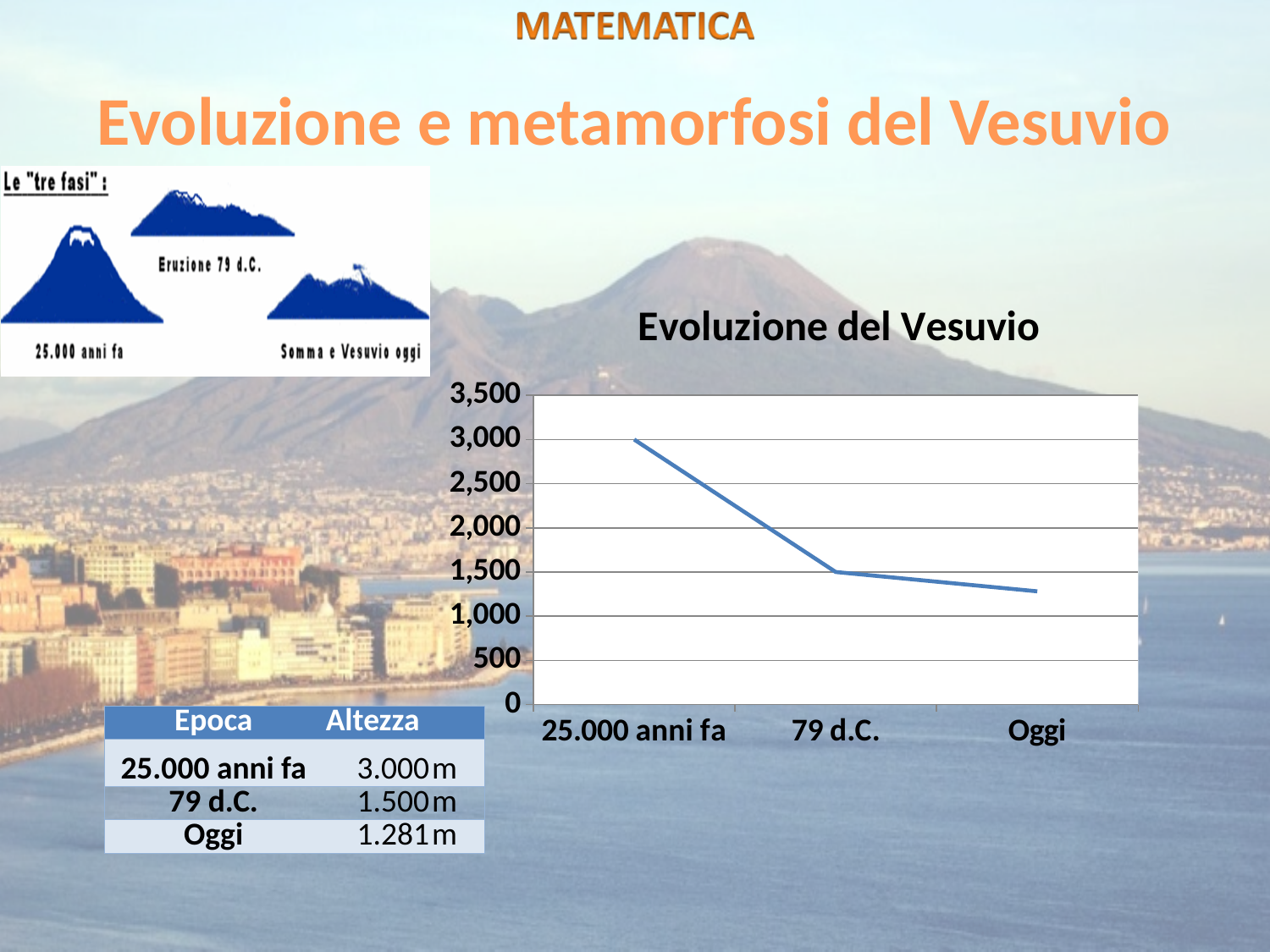
Which category has the lowest value in the chart? Oggi What is the value for 25.000 anni fa in the chart? 3,000 How many points are plotted on the line in the chart? 3 Which category has the highest value in the chart? 25.000 anni fa Which is larger, the value for 79 d.C. or the value for Oggi? 79 d.C. Do the values rise or fall along the x axis from 25.000 anni fa to Oggi? fall According to the table on the slide, what is the height (Altezza) for Oggi? 1.281 m What is the difference between the value for 25.000 anni fa and the value for 79 d.C.? 1,500 What is the value for 79 d.C. in the chart? 1,500 What is the title of the chart? Evoluzione del Vesuvio What kind of chart is shown on the slide? line chart Is the value for Oggi greater or less than 1,500? less